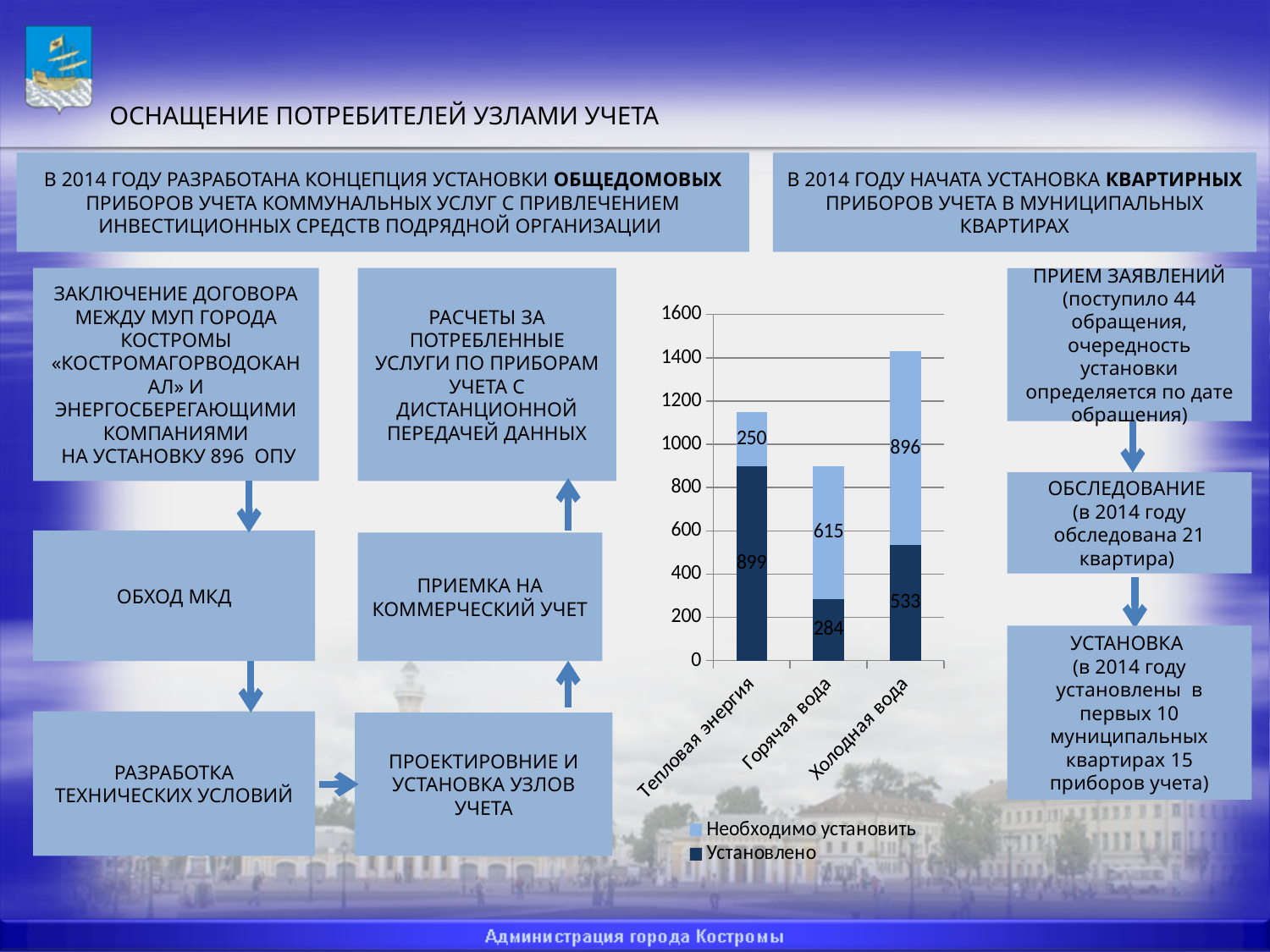
Which category has the lowest value for Необходимо установить? Тепловая энергия What is the difference between Необходимо установить and Установлено for Горячая вода? 331 Which category has the highest value for Установлено? Тепловая энергия What is the value of Установлено for Тепловая энергия? 899 What is the value of Необходимо установить for Холодная вода? 896 What is the value of Необходимо установить for Горячая вода? 615 Which is larger: Установлено for Холодная вода or Установлено for Горячая вода? Холодная вода What kind of chart is shown on the slide? stacked bar chart What is the value of Установлено for Горячая вода? 284 What is the total of the stacked bar for Холодная вода? 1429 How many categories are shown on the x axis of the chart? 3 How many series does the chart legend list? 2